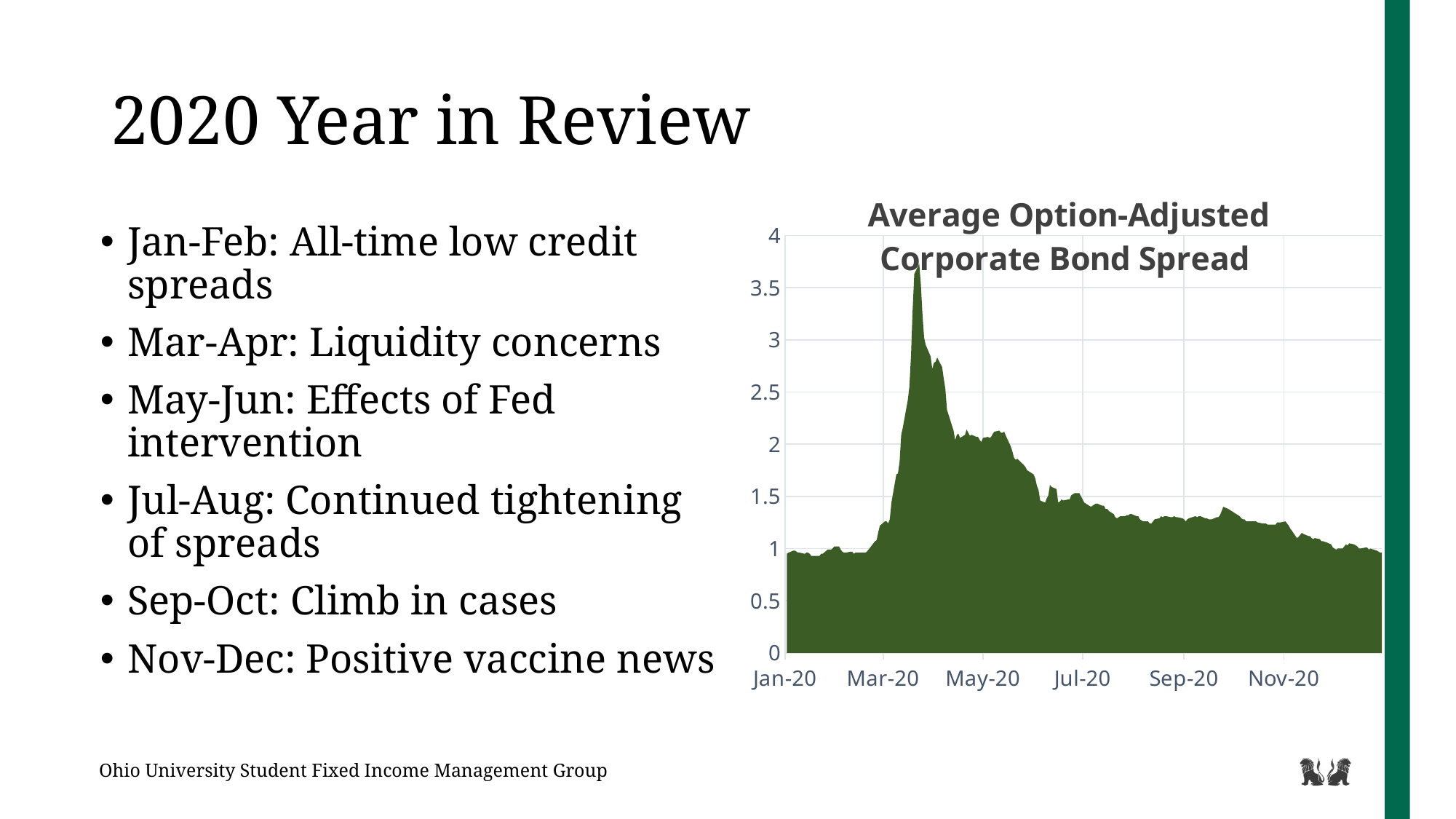
What type of chart is shown on the slide? Area chart Which is larger, the spread at May-20 or the spread at Nov-20? May-20 Is the spread at May-20 greater or less than 1.5? greater Does the spread rise or fall between May-20 and Jul-20? Fall Is the spread at Sep-20 greater or less than 2? less Is the spread at Nov-20 greater or less than 1.5? less What is the title of the chart? Average Option-Adjusted Corporate Bond Spread Between which two labelled months on the x axis does the spread reach its peak? Mar-20 and May-20 How many month labels are shown on the x axis of the chart? 6 What is the highest value shown on the y axis of the chart? 4